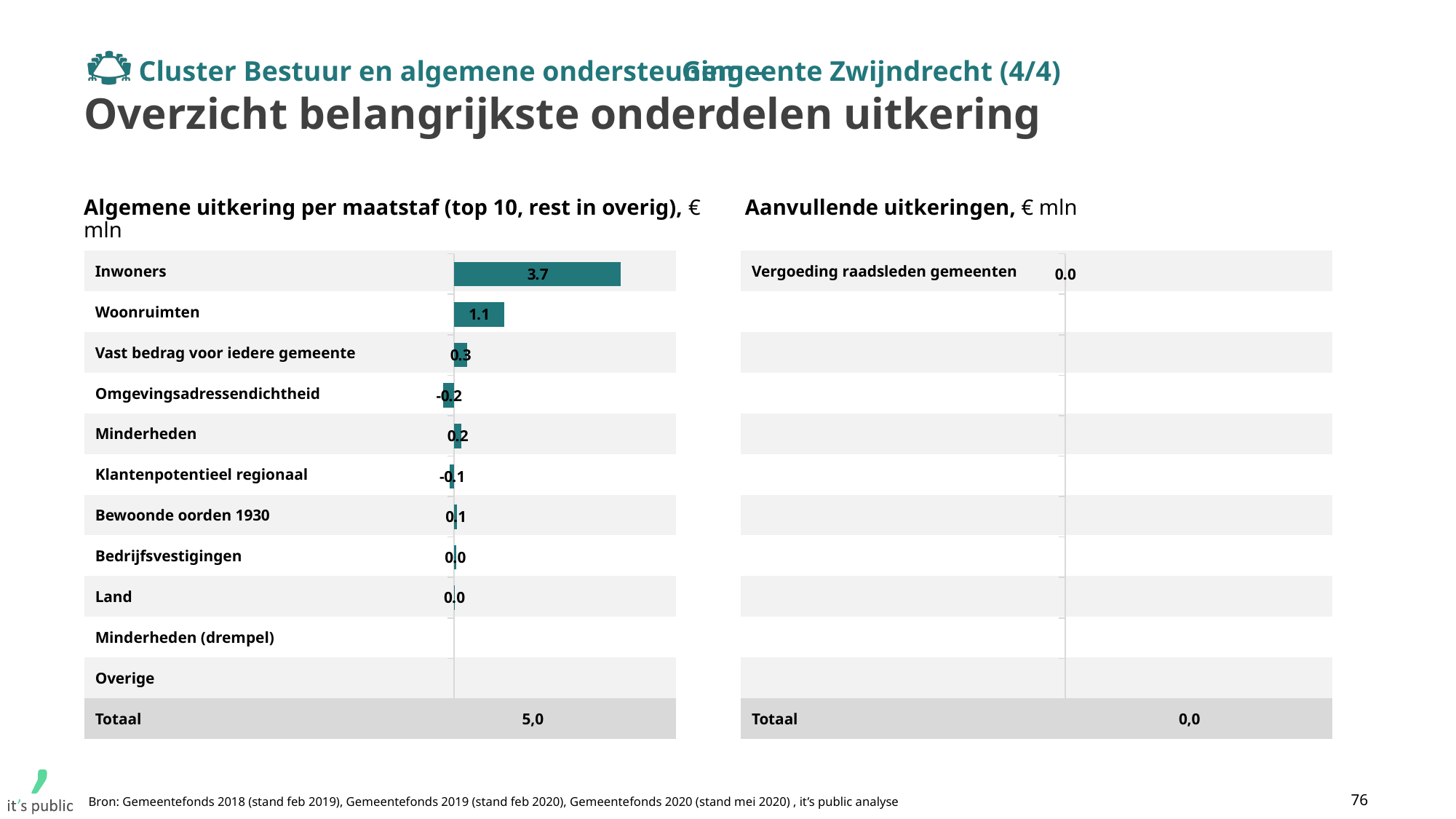
In the left chart 'Algemene uitkering per maatstaf', what is the value for Inwoners? 3.7 In the left chart 'Algemene uitkering per maatstaf', what is the value shown for Totaal? 5,0 What kind of chart is the left chart 'Algemene uitkering per maatstaf'? bar chart In the left chart 'Algemene uitkering per maatstaf', what is the value for Klantenpotentieel regionaal? -0.1 In the right chart 'Aanvullende uitkeringen', what is the value for Vergoeding raadsleden gemeenten? 0.0 In the right chart 'Aanvullende uitkeringen', what is the value shown for Totaal? 0,0 In the left chart 'Algemene uitkering per maatstaf', what is the value for Woonruimten? 1.1 In the left chart 'Algemene uitkering per maatstaf', which category has the lowest value? Omgevingsadressendichtheid In the left chart 'Algemene uitkering per maatstaf', what is the difference between the values for Inwoners and Woonruimten? 2.6 In the left chart 'Algemene uitkering per maatstaf', what is the value for Omgevingsadressendichtheid? -0.2 In the left chart 'Algemene uitkering per maatstaf', which is larger: Woonruimten or Vast bedrag voor iedere gemeente? Woonruimten In the left chart 'Algemene uitkering per maatstaf', which category has the highest value? Inwoners